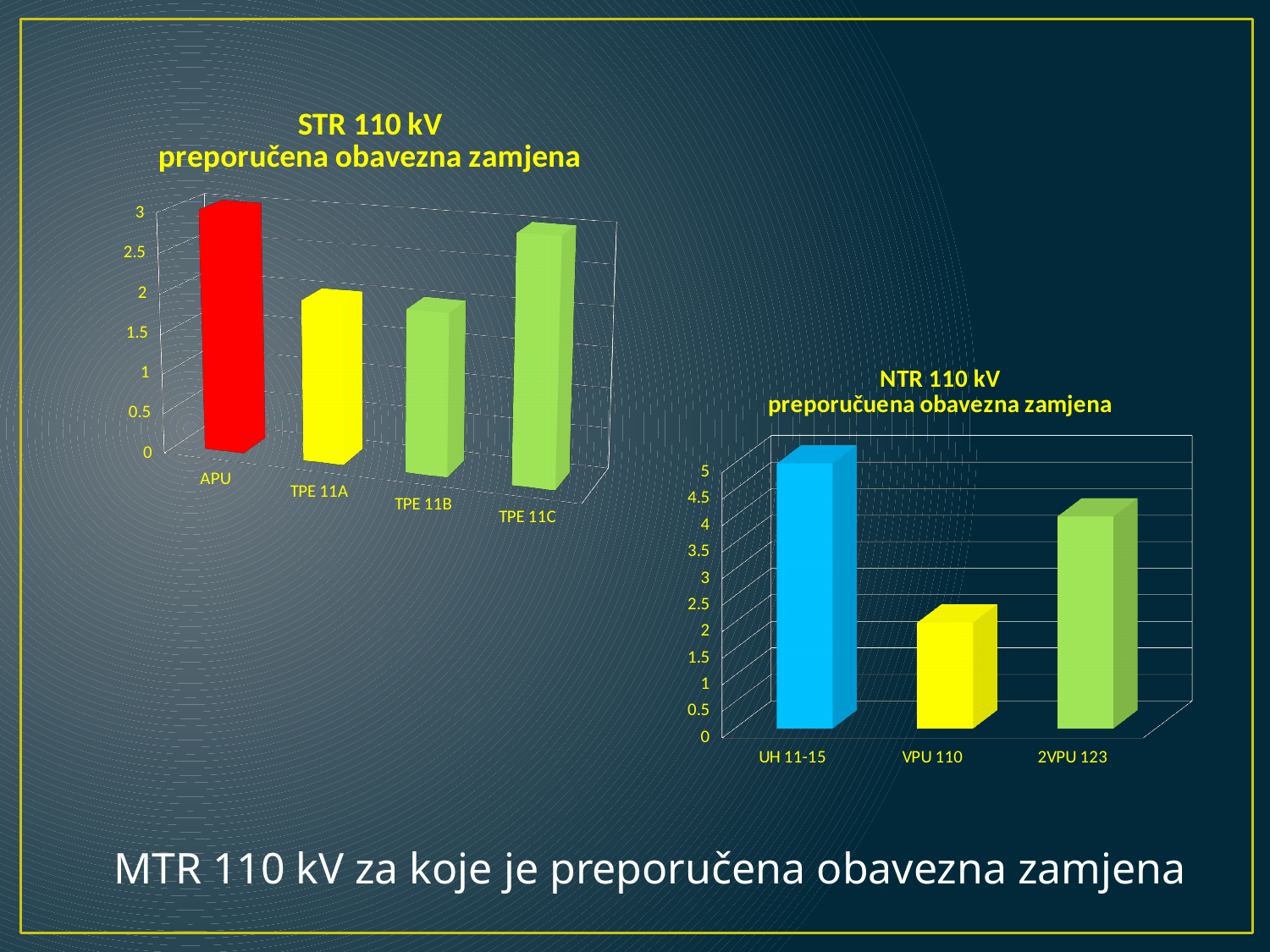
On the 'STR 110 kV preporučena obavezna zamjena' chart, is the value for TPE 11B greater or less than 1? greater On the 'NTR 110 kV preporučuena obavezna zamjena' chart, which category has the lowest value? VPU 110 On the 'NTR 110 kV preporučuena obavezna zamjena' chart, which is larger, the value for 2VPU 123 or the value for VPU 110? 2VPU 123 How many categories are shown on the 'STR 110 kV preporučena obavezna zamjena' chart? 4 On the 'NTR 110 kV preporučuena obavezna zamjena' chart, is the value for VPU 110 greater or less than 3? less On the 'STR 110 kV preporučena obavezna zamjena' chart, what colour is the bar for APU? red How many categories are shown on the 'NTR 110 kV preporučuena obavezna zamjena' chart? 3 On the 'STR 110 kV preporučena obavezna zamjena' chart, is the value for TPE 11A greater or less than 3? less On the 'NTR 110 kV preporučuena obavezna zamjena' chart, which category has the highest value? UH 11-15 What kind of chart is the 'NTR 110 kV preporučuena obavezna zamjena' chart? bar chart What kind of chart is the 'STR 110 kV preporučena obavezna zamjena' chart? bar chart